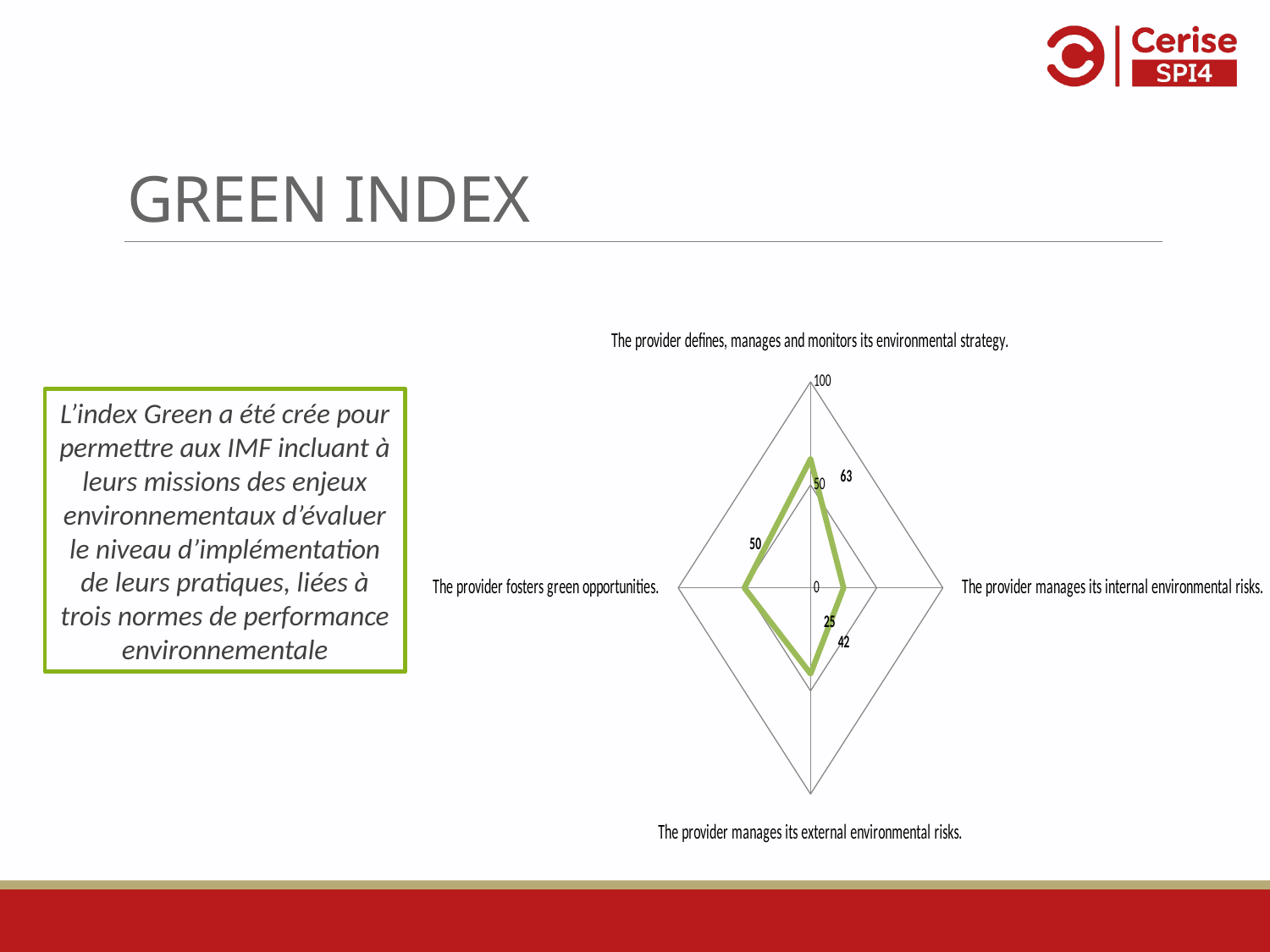
What is the maximum value shown on the radar chart's axis scale? 100 What is the value for "The provider defines, manages and monitors its environmental strategy" on the radar chart? 63 What is the value for "The provider manages its external environmental risks" on the radar chart? 42 Which axis of the radar chart has the lowest value? The provider manages its internal environmental risks. How many axes (categories) does the radar chart have? 4 What kind of chart is shown on the slide? Radar chart Which is larger: the value for "The provider defines, manages and monitors its environmental strategy" or the value for "The provider manages its external environmental risks"? The provider defines, manages and monitors its environmental strategy. What is the difference between the value for environmental strategy (63) and the value for green opportunities (50)? 13 What is the difference between the value for environmental strategy (63) and the value for external environmental risks (42)? 21 Is the value for "The provider manages its internal environmental risks" greater or less than 50? less What is the value for "The provider fosters green opportunities" on the radar chart? 50 Which axis of the radar chart has the highest value? The provider defines, manages and monitors its environmental strategy.